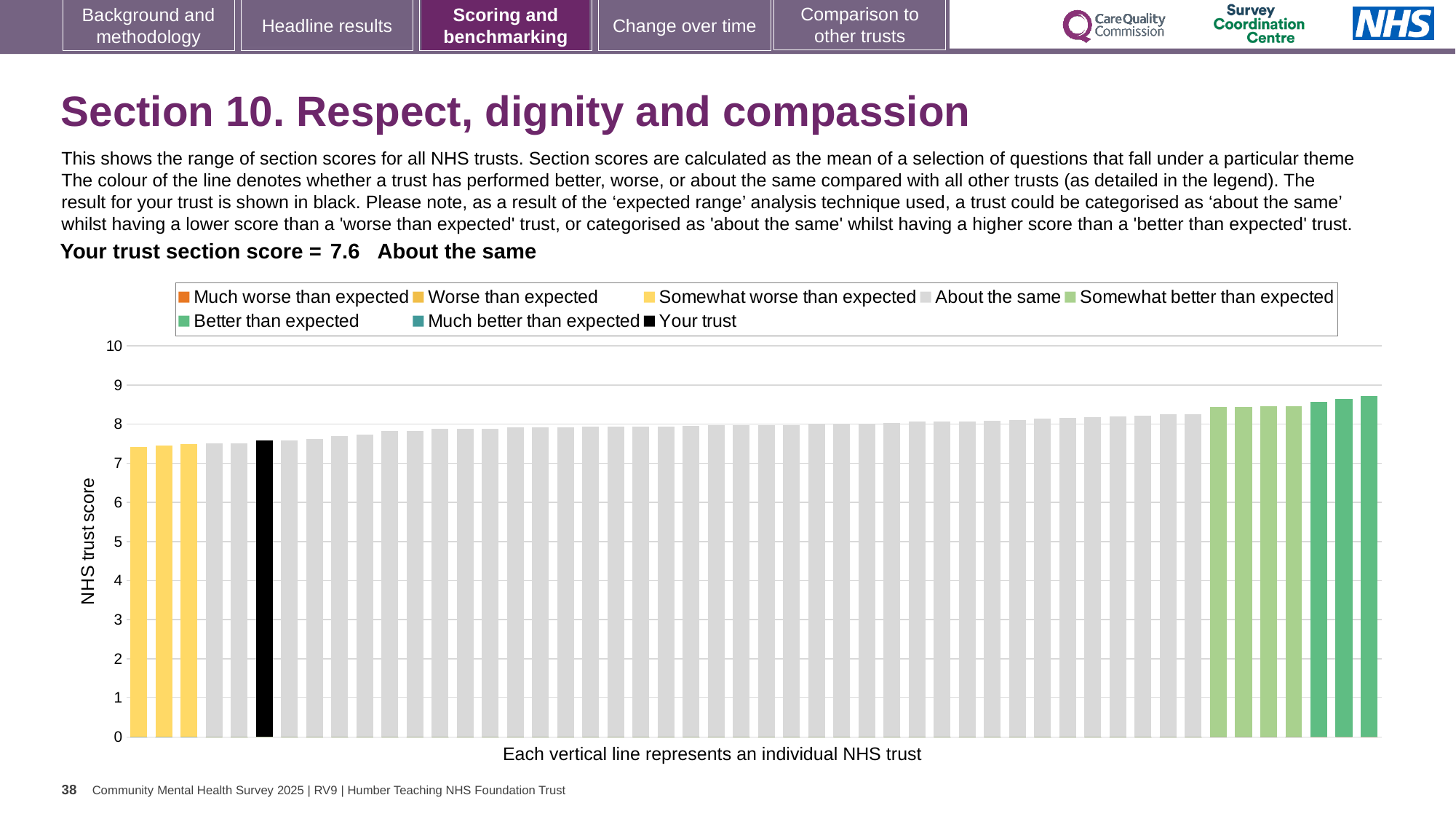
Is the highest bar on the chart greater or less than 9? less What kind of chart is shown on the slide? bar chart How many bars are coloured as 'Better than expected'? 3 How many categories does the chart legend list? 8 What colour is the bar representing your trust? black Do the bar values rise or fall from left to right along the x axis? rise Is the value for your trust greater or less than 7? greater What is the label on the vertical axis of the chart? NHS trust score Which legend category does your trust fall into? About the same How many bars are coloured as 'Somewhat worse than expected'? 3 What is the section score for your trust? 7.6 Is the lowest bar on the chart greater or less than 8? less